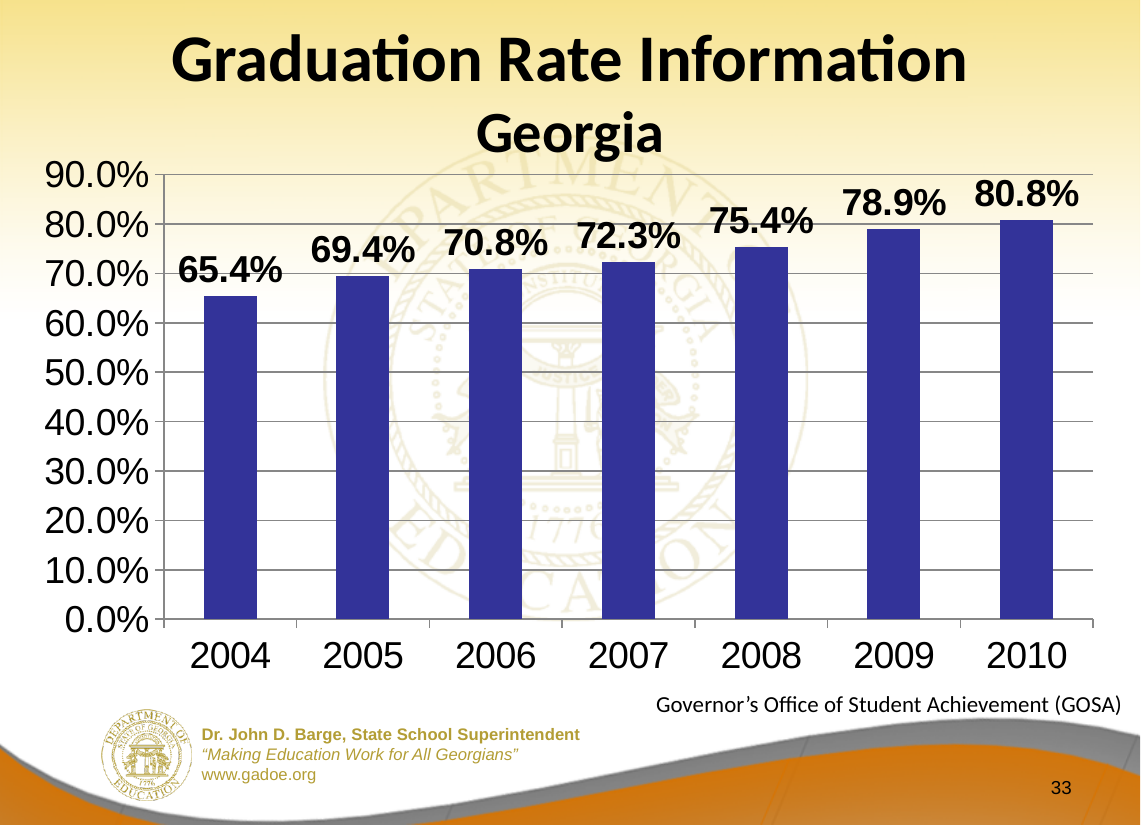
What kind of chart is shown on the slide? Bar chart How many years are shown on the chart? 7 Do the graduation rates rise or fall from 2004 to 2010? Rise What is the difference between the graduation rates for 2009 and 2008? 3.5% What is the graduation rate shown for 2008? 75.4% Which year has a higher graduation rate, 2006 or 2007? 2007 Which year has the highest graduation rate? 2010 Which year has the lowest graduation rate? 2004 What is the graduation rate shown for 2004? 65.4% What is the graduation rate shown for 2010? 80.8% What is the difference between the graduation rates for 2010 and 2004? 15.4% Is the graduation rate for 2009 greater or less than 70.0%? greater